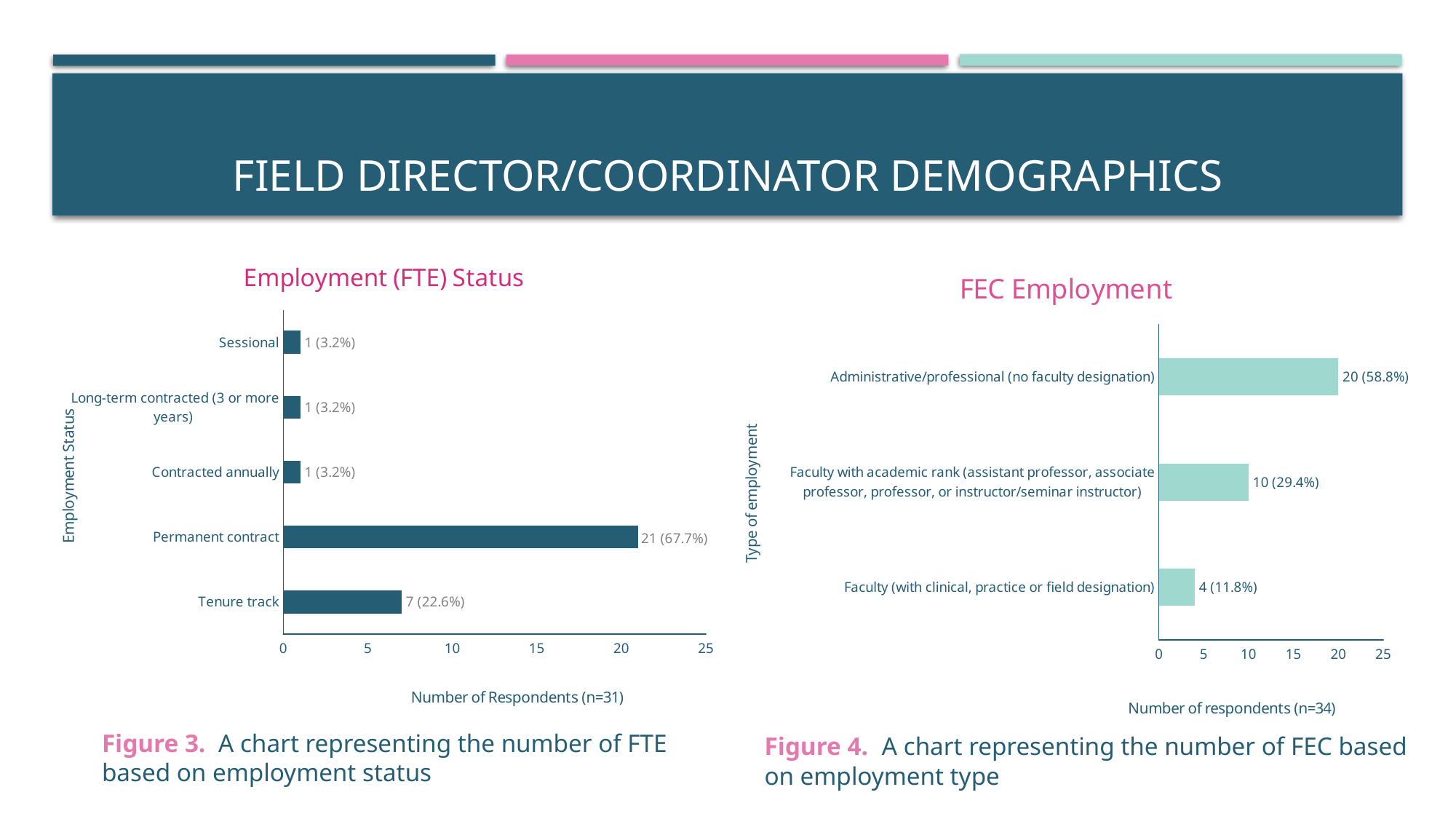
In the FEC Employment chart, what is the value for Administrative/professional (no faculty designation)? 20 (58.8%) In the Employment (FTE) Status chart, what is the difference in respondents between Permanent contract and Tenure track? 14 In the Employment (FTE) Status chart, is the value for Permanent contract greater or less than 20? greater What is the x-axis label of the Employment (FTE) Status chart? Number of Respondents (n=31) In the FEC Employment chart, what is the value for Faculty (with clinical, practice or field designation)? 4 (11.8%) In the Employment (FTE) Status chart, what is the value for Tenure track? 7 (22.6%) In the Employment (FTE) Status chart, what is the value for Permanent contract? 21 (67.7%) In the Employment (FTE) Status chart, how many employment status categories are shown? 5 In the FEC Employment chart, which type of employment has the lowest number of respondents? Faculty (with clinical, practice or field designation) What kind of chart is the FEC Employment chart? Bar chart In the FEC Employment chart, what is the difference in respondents between Administrative/professional (no faculty designation) and Faculty with academic rank? 10 In the Employment (FTE) Status chart, which employment status has the highest number of respondents? Permanent contract